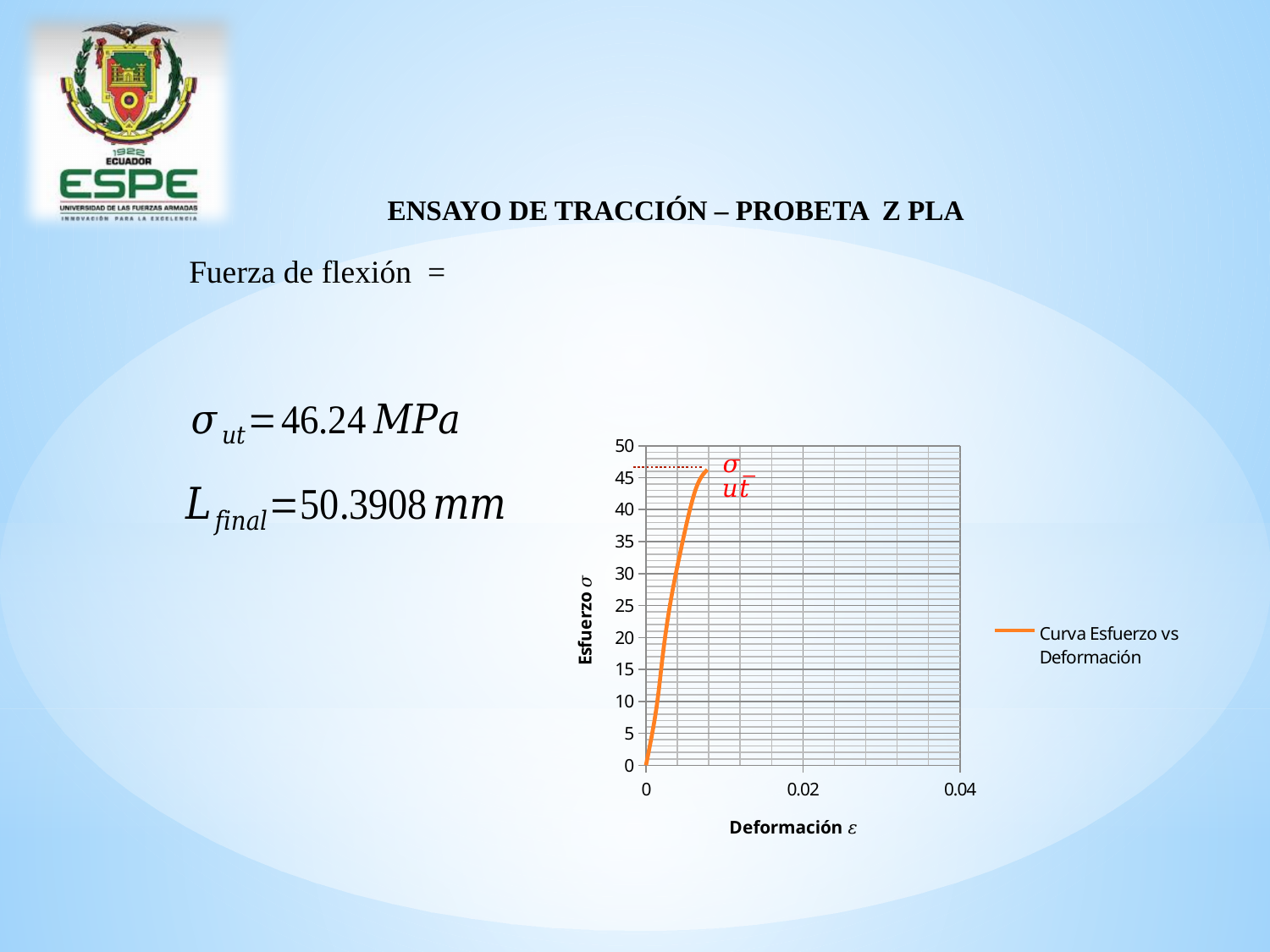
What is the highest tick value shown on the x axis (Deformación ε)? 0.04 What is the name of the series shown in the chart legend? Curva Esfuerzo vs Deformación What type of chart is shown on the slide? line chart What colour is the plotted curve in the chart? orange Is the maximum stress reached by the curve greater or less than 50? less What is the highest tick value shown on the y axis (Esfuerzo σ)? 50 What is the value of σ_ut marked on the chart, as stated on the slide? 46.24 MPa How many series does the chart legend list? 1 Is the maximum stress reached by the curve greater or less than 40? greater Does the stress (Esfuerzo) rise or fall as the strain (Deformación) increases along the x axis? rises Is the strain at which the curve ends greater or less than 0.02? less